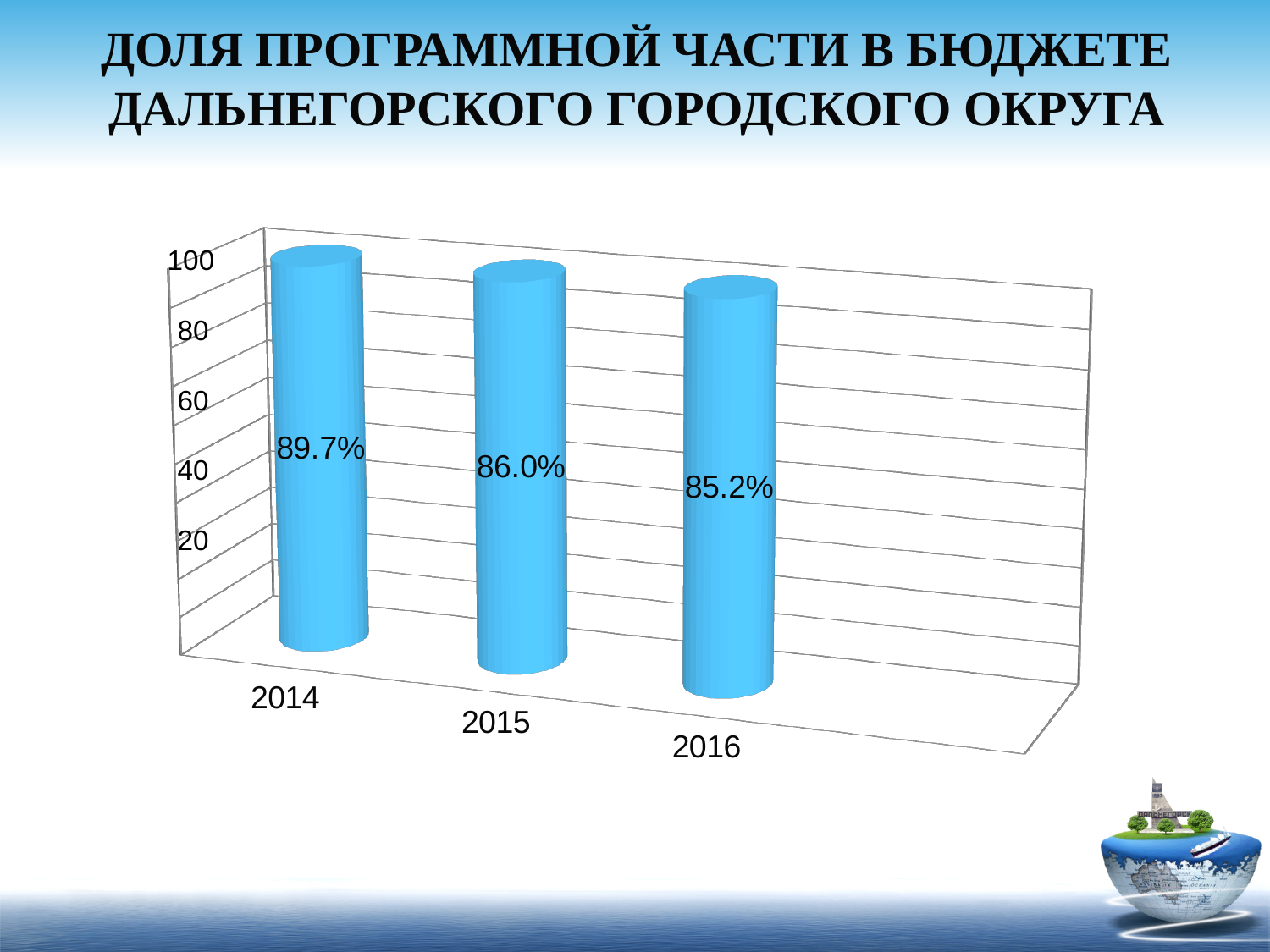
Do the values rise or fall from 2014 to 2016? fall Which year has the lowest value? 2016 Which is larger, the value for 2015 or the value for 2016? 2015 How many years are shown on the chart? 3 What is the value for 2014? 89.7% Is the value for 2016 greater or less than 80? greater What is the value for 2015? 86.0% What kind of chart is shown on the slide? bar chart What is the value for 2016? 85.2% What is the difference between the values for 2014 and 2016? 4.5% What is the difference between the values for 2014 and 2015? 3.7% Which year has the highest value? 2014